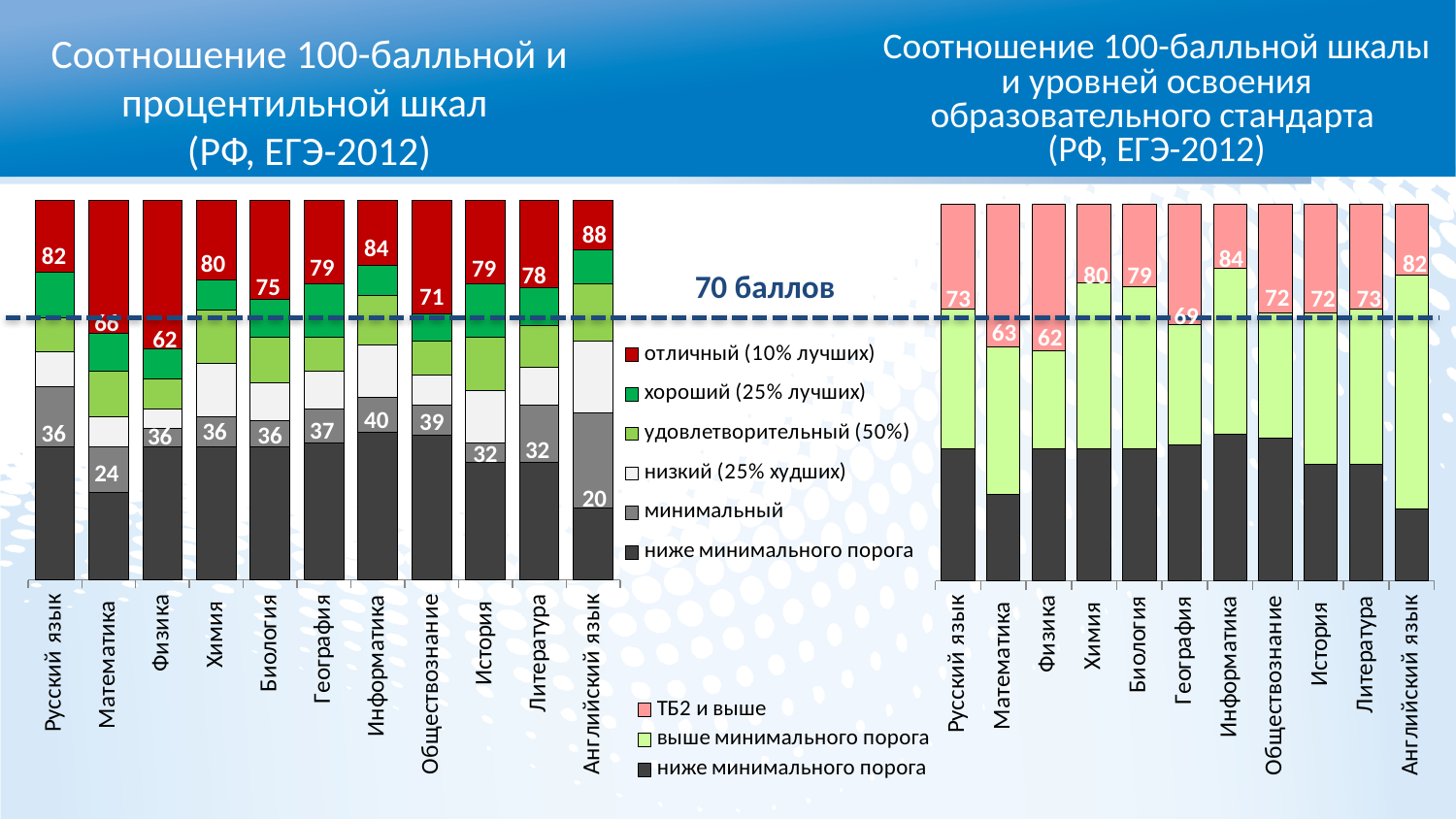
What type of chart is the right chart (Соотношение 100-балльной шкалы и уровней освоения образовательного стандарта)? Stacked bar chart On the right chart (Соотношение 100-балльной шкалы и уровней освоения образовательного стандарта), what value is labelled for Информатика? 84 On the left chart (Соотношение 100-балльной и процентильной шкал), how many series does the legend list? 6 On the left chart (Соотношение 100-балльной и процентильной шкал), what is the upper value labelled for Английский язык? 88 On the left chart (Соотношение 100-балльной и процентильной шкал), what is the lower value labelled for Математика? 24 On the left chart (Соотношение 100-балльной и процентильной шкал), how many subjects are shown on the x axis? 11 On the left chart (Соотношение 100-балльной и процентильной шкал), which subject has the highest upper labelled value? Английский язык On the right chart (Соотношение 100-балльной шкалы и уровней освоения образовательного стандарта), how many series does the legend list? 3 On the right chart (Соотношение 100-балльной шкалы и уровней освоения образовательного стандарта), which is larger, the labelled value for Химия or for Русский язык? Химия On the left chart (Соотношение 100-балльной и процентильной шкал), what is the difference between the upper labelled values for Информатика and Физика? 22 On the right chart (Соотношение 100-балльной шкалы и уровней освоения образовательного стандарта), which subject has the lowest labelled value? Физика On the left chart (Соотношение 100-балльной и процентильной шкал), which subject has the lowest lower labelled value? Английский язык